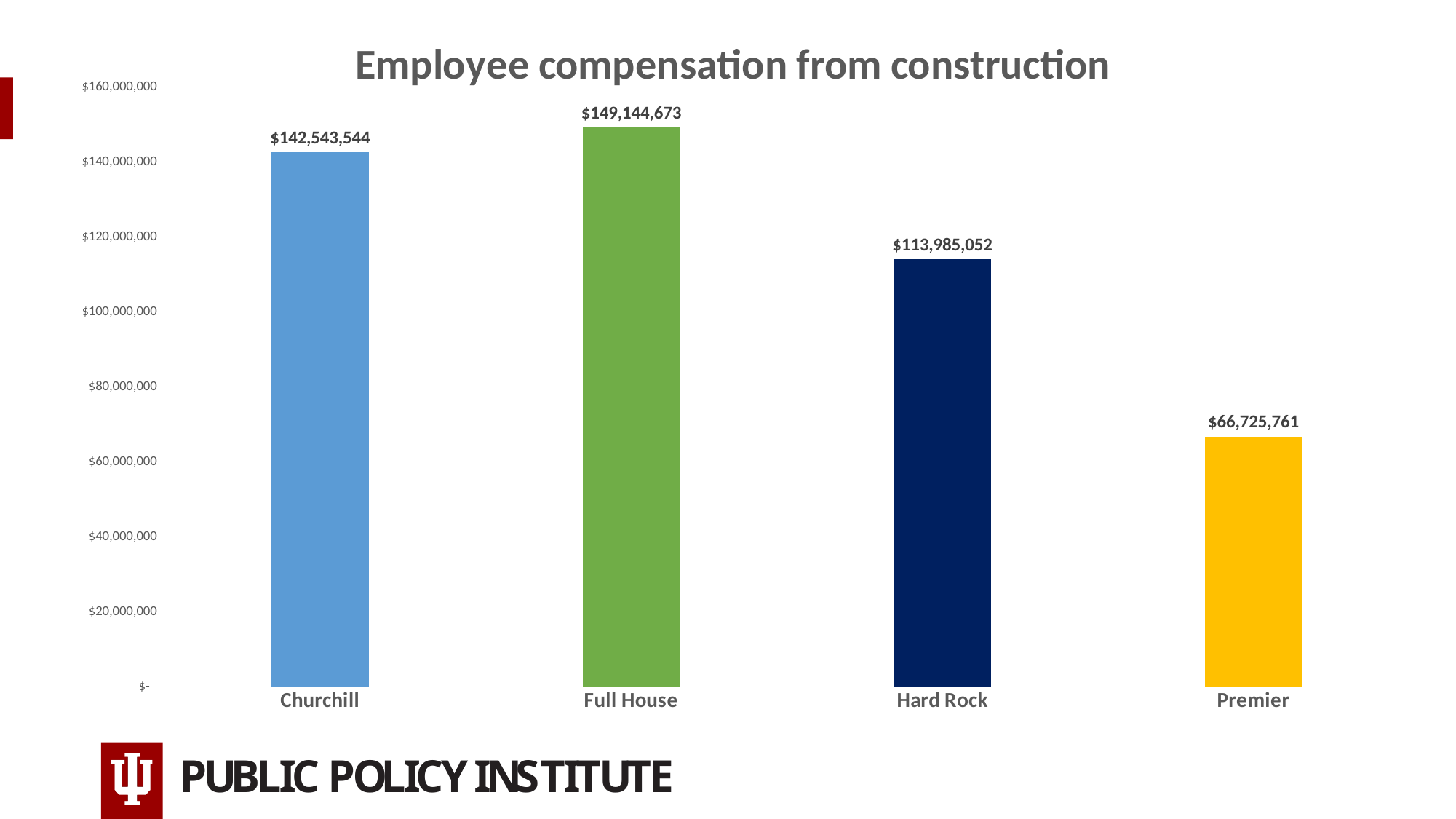
What is the difference between Hard Rock and Premier in employee compensation from construction? $47,259,291 What is the employee compensation from construction for Premier? $66,725,761 Which is larger, the value for Churchill or the value for Hard Rock? Churchill Which category has the lowest employee compensation from construction? Premier What is the employee compensation from construction for Churchill? $142,543,544 How many categories are shown in the chart? 4 What type of chart is shown on the slide? Bar chart What is the employee compensation from construction for Hard Rock? $113,985,052 Is the value for Premier greater or less than $80,000,000? less What is the difference between Full House and Churchill in employee compensation from construction? $6,601,129 What is the employee compensation from construction for Full House? $149,144,673 Which category has the highest employee compensation from construction? Full House